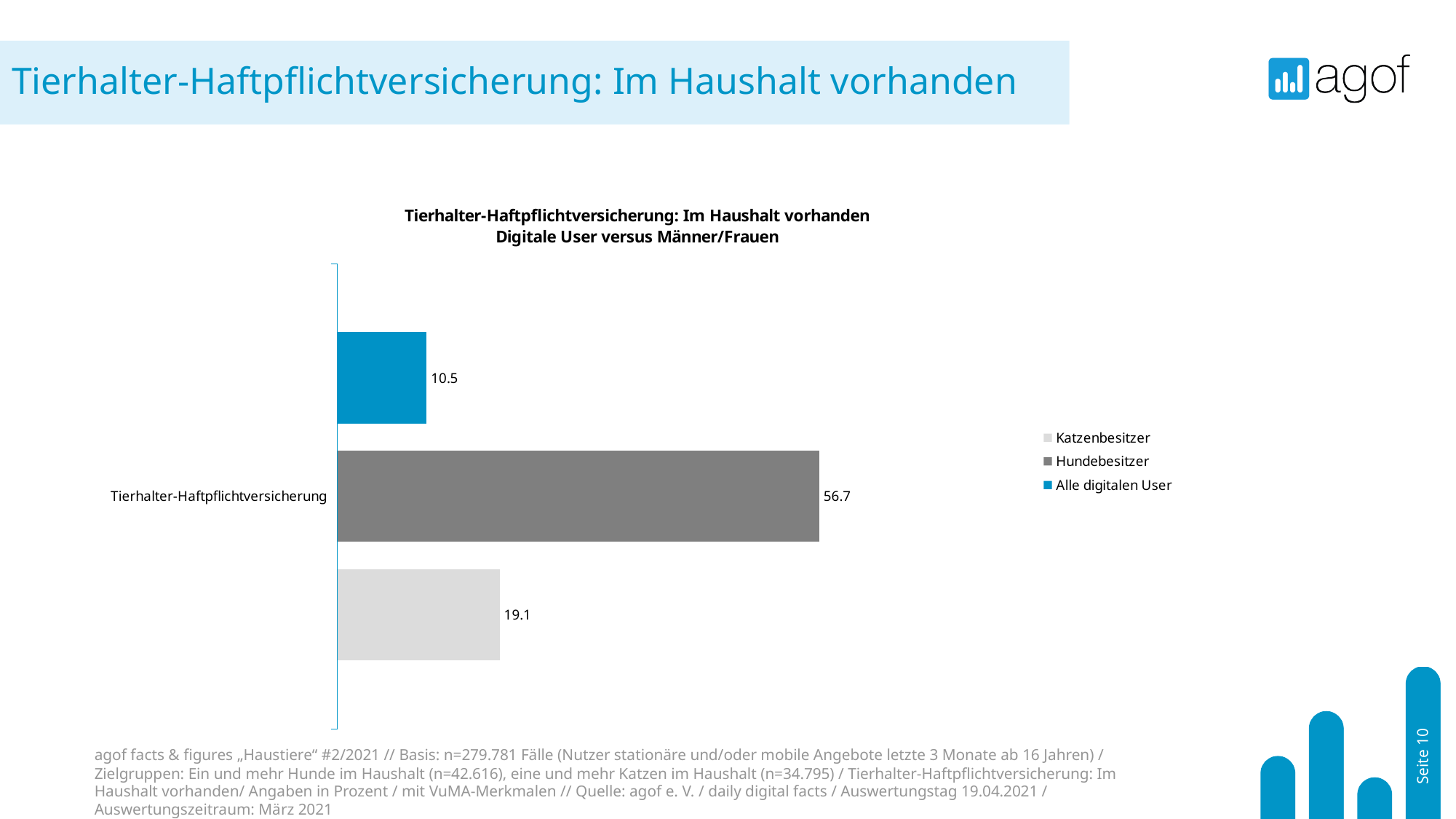
Which is larger, the value for Katzenbesitzer or the value for Alle digitalen User? Katzenbesitzer How many series does the legend list? 3 Which series has the highest value? Hundebesitzer What kind of chart is shown on the slide? bar chart What is the value for Katzenbesitzer? 19.1 Which series is shown in blue in the chart? Alle digitalen User What is the difference between the values for Katzenbesitzer and Alle digitalen User? 8.6 What is the difference between the values for Hundebesitzer and Katzenbesitzer? 37.6 What is the value for Hundebesitzer? 56.7 What is the value for Alle digitalen User? 10.5 Which series has the lowest value? Alle digitalen User What is the category label shown on the vertical axis of the chart? Tierhalter-Haftpflichtversicherung